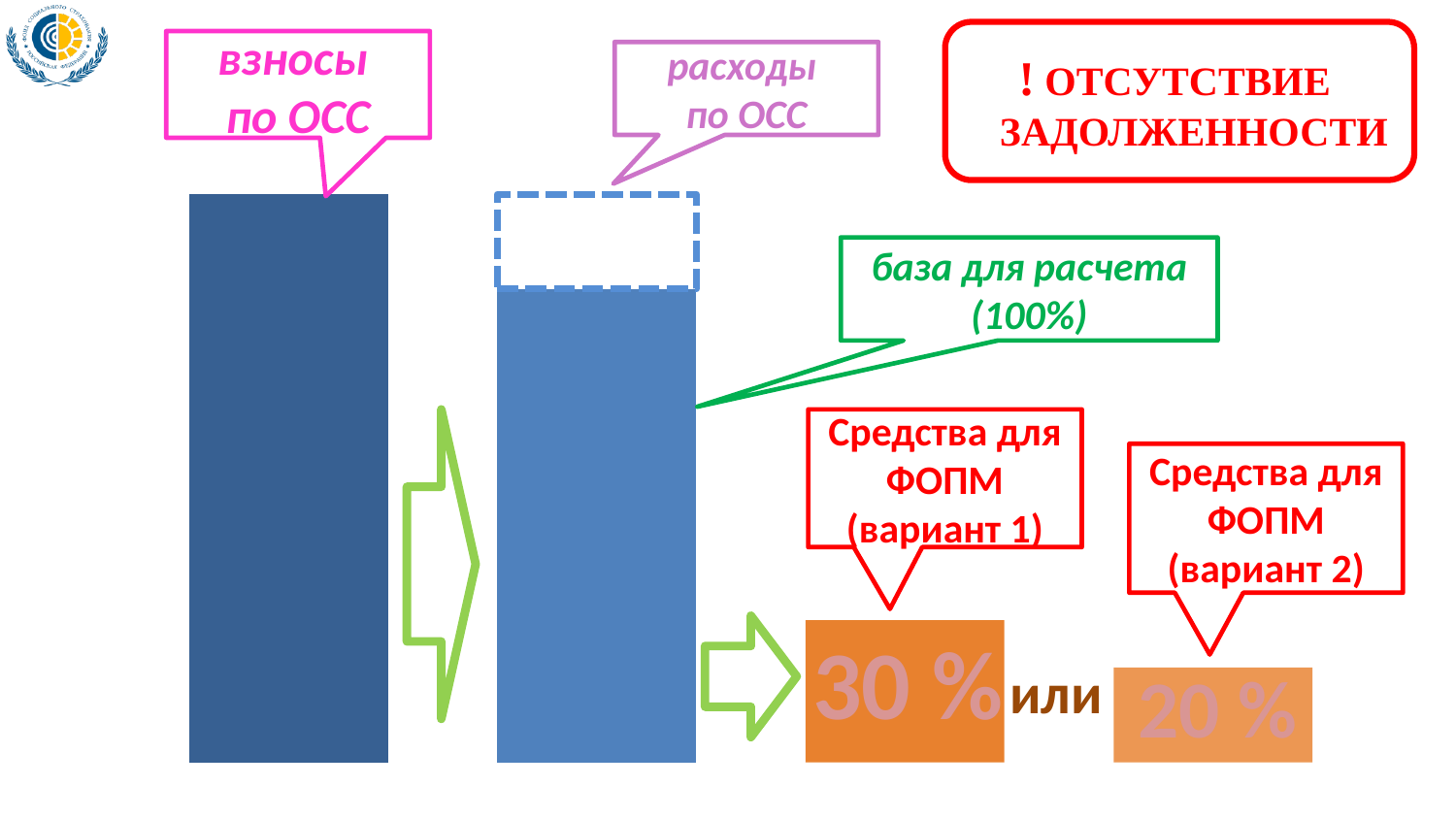
What percentage is shown for 'Средства для ФОПМ (вариант 2)'? 20 % What percentage is given for 'база для расчета'? 100% What is the difference between the percentages for вариант 1 and вариант 2? 10 % What does the dashed outline at the top of the second bar represent? расходы по ОСС Which of the two ФОПМ options has the lowest percentage? вариант 2 Which is larger, the percentage for вариант 1 or for вариант 2? вариант 1 What does the label on the first (dark blue) bar say? взносы по ОСС What percentage is shown for 'Средства для ФОПМ (вариант 1)'? 30 %